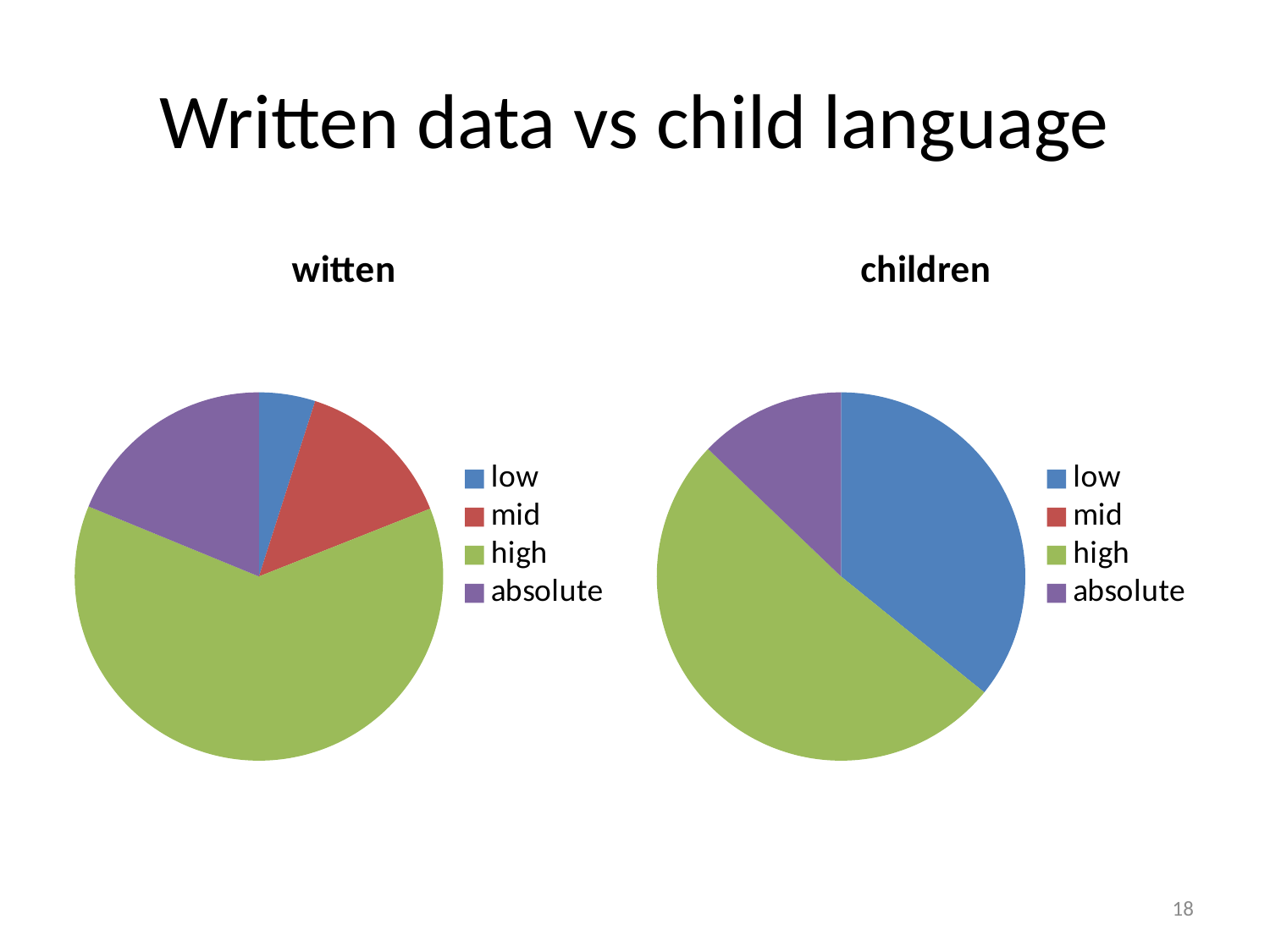
What kind of chart is the "children" chart on the right? pie chart In the "children" chart, which slice is larger, high or low? high In the "witten" chart, which category has the largest slice? high What kind of chart is the "witten" chart on the left? pie chart In the "witten" chart, which category has the smallest slice? low In the "children" chart, what colour is the high slice? green How many categories does the legend of the "children" chart list? 4 How many categories does the legend of the "witten" chart list? 4 In the "children" chart, which category has the largest slice? high In the "witten" chart, which slice is larger, low or mid? mid What is the title of the slide? Written data vs child language In the "children" chart, which slice is larger, low or absolute? low